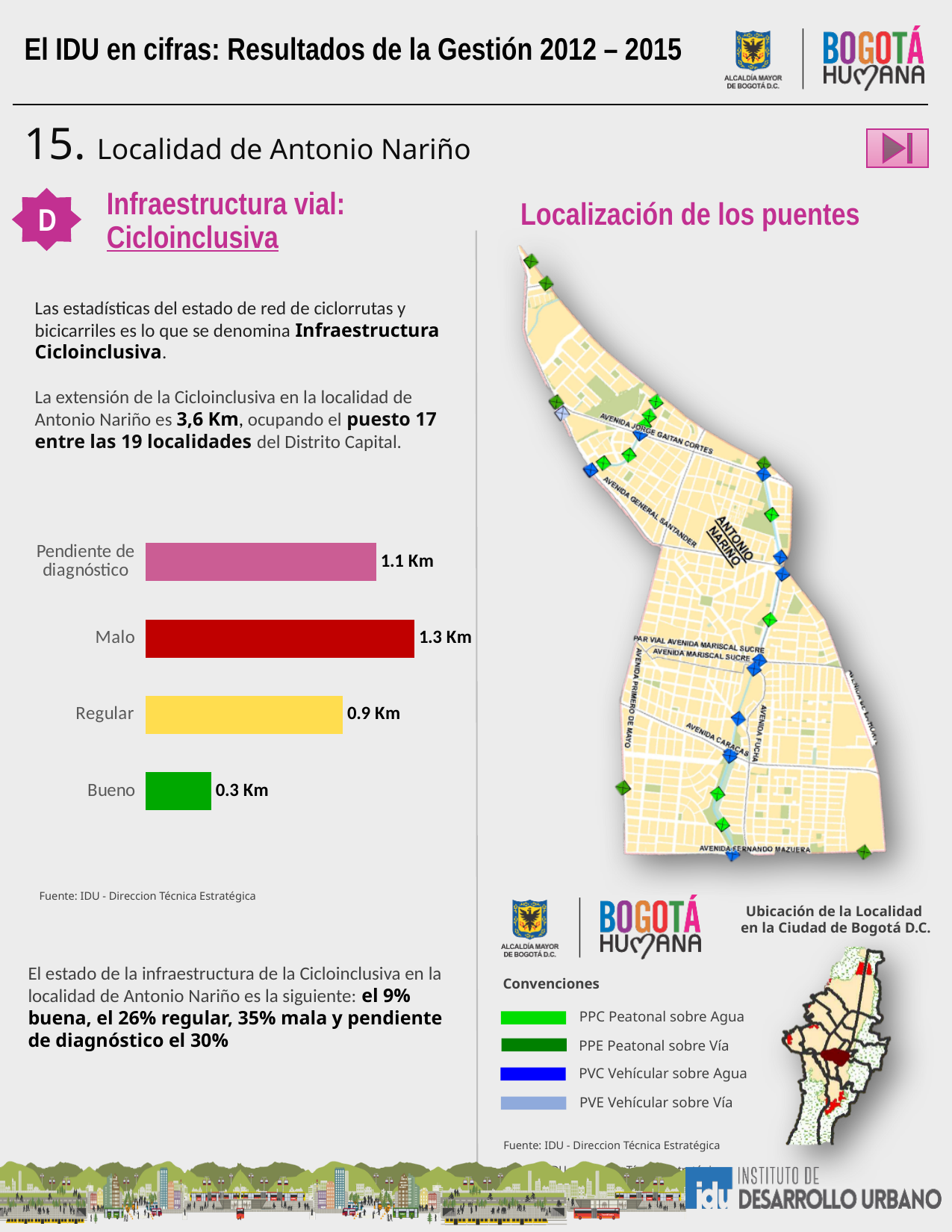
Which is larger in the bar chart, the value for Regular or the value for Pendiente de diagnóstico? Pendiente de diagnóstico How many categories are shown in the bar chart? 4 What colour is the bar for Malo in the bar chart? Red What is the difference between the values for Pendiente de diagnóstico and Regular in the bar chart? 0.2 Km What is the value for Pendiente de diagnóstico in the bar chart? 1.1 Km Which category has the highest value in the bar chart? Malo What kind of chart is used to show the state of the Cicloinclusiva infrastructure? Bar chart What is the difference between the values for Malo and Bueno in the bar chart? 1.0 Km Which category has the lowest value in the bar chart? Bueno What is the value for Malo in the bar chart? 1.3 Km What is the value for Regular in the bar chart? 0.9 Km What is the value for Bueno in the bar chart? 0.3 Km